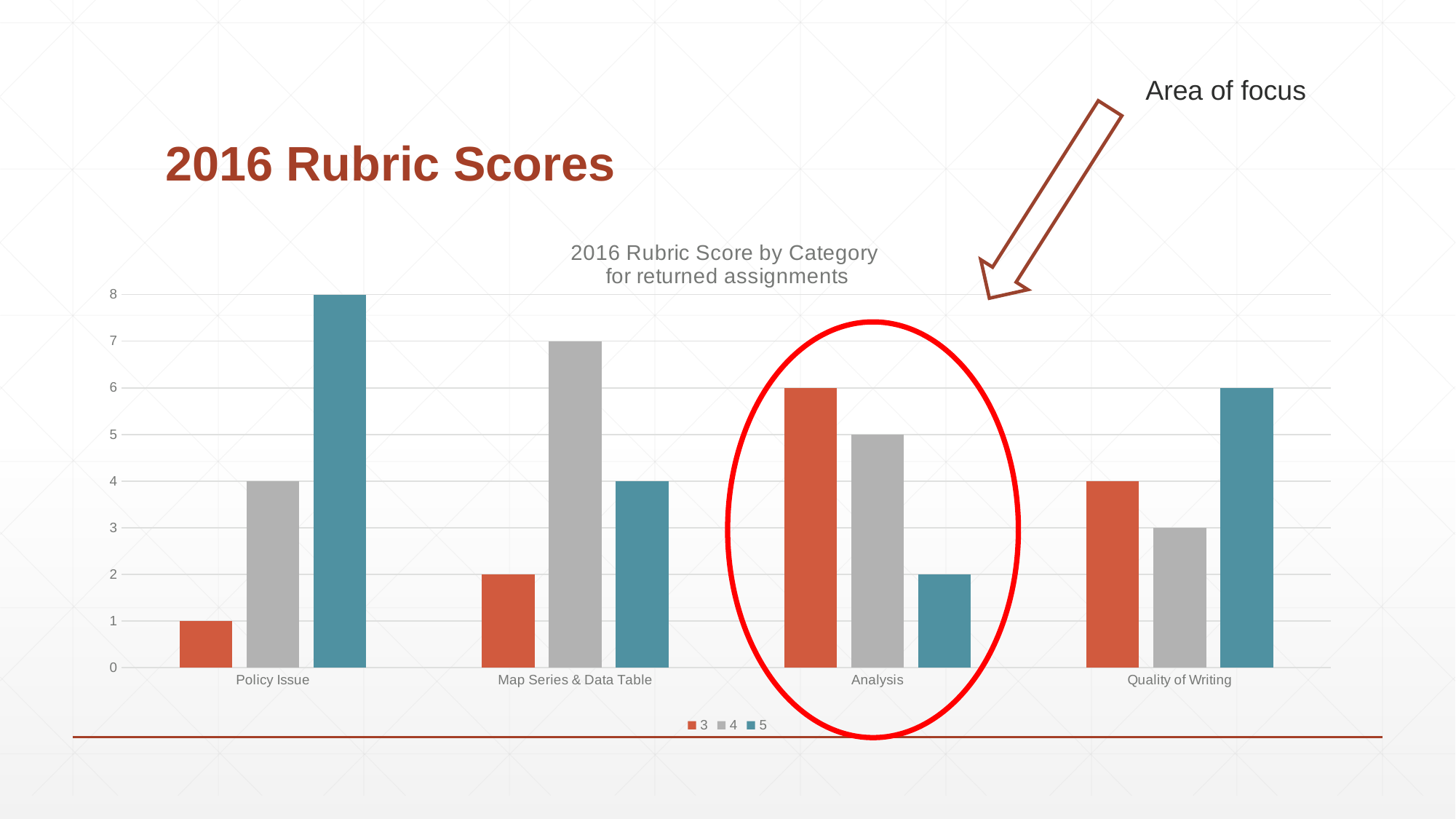
What is the title of the chart? 2016 Rubric Score by Category for returned assignments What is the difference between the series 4 value and the series 5 value for Analysis? 3 What is the value of series 4 for Map Series & Data Table? 7 What is the value of series 5 for Quality of Writing? 6 How many categories are shown on the x axis of the chart? 4 How many series does the chart's legend list? 3 What is the value of series 3 for Analysis? 6 Which category has the lowest value for series 3? Policy Issue What is the value of series 5 for Policy Issue? 8 Which category has the highest value for series 5? Policy Issue What kind of chart is shown on the slide? Bar chart For Quality of Writing, which is larger: the value for series 3 or the value for series 4? Series 3